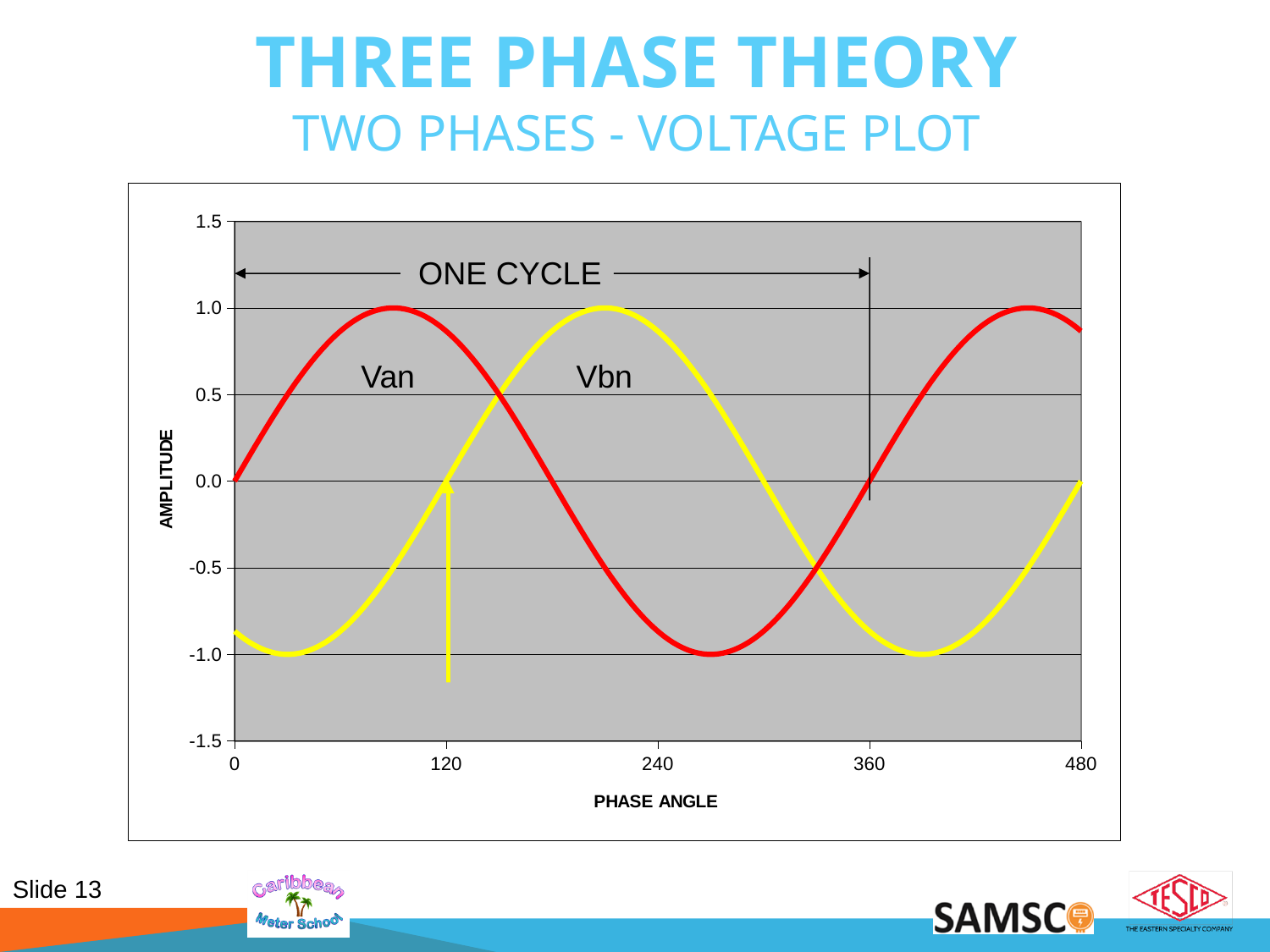
What kind of chart is shown on the slide? line chart How many voltage waveforms are plotted on the chart? 2 What is the maximum amplitude reached by Van? 1.0 What is the amplitude of Van at a phase angle of 360? 0.0 What colour is the Vbn waveform drawn in? yellow At a phase angle of 240, which waveform has the larger amplitude, Van or Vbn? Vbn What is the amplitude of Van at a phase angle of 0? 0.0 What is the minimum amplitude reached by Vbn? -1.0 Is the amplitude of Van at a phase angle of 120 greater or less than 0.5? greater Does the amplitude of Van rise or fall between phase angles 120 and 240? fall Is the amplitude of Vbn at a phase angle of 0 greater or less than -0.5? less What is the amplitude of Vbn at a phase angle of 120? 0.0